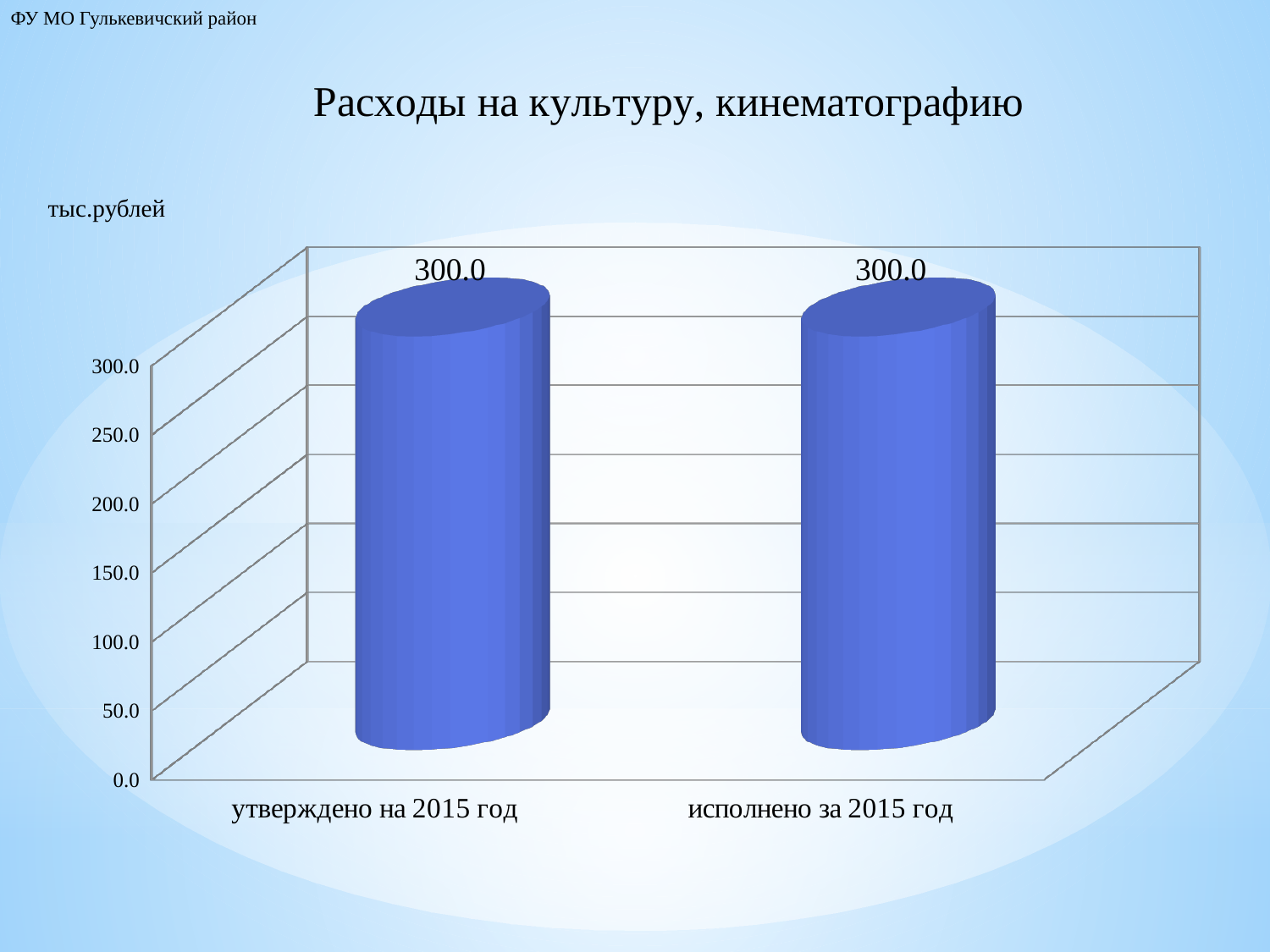
How many categories are shown on the x axis? 2 Is the value for "исполнено за 2015 год" greater or less than 250.0? greater What is the total of the two values shown on the chart? 600.0 What is the title of the chart? Расходы на культуру, кинематографию What is the value for "утверждено на 2015 год"? 300.0 What unit is indicated for the values on the chart? тыс.рублей Do the values rise, fall, or stay the same from "утверждено на 2015 год" to "исполнено за 2015 год"? stay the same What kind of chart is shown on the slide? bar chart What is the difference between the values for "утверждено на 2015 год" and "исполнено за 2015 год"? 0.0 Is the value for "утверждено на 2015 год" greater or less than 200.0? greater What is the value for "исполнено за 2015 год"? 300.0